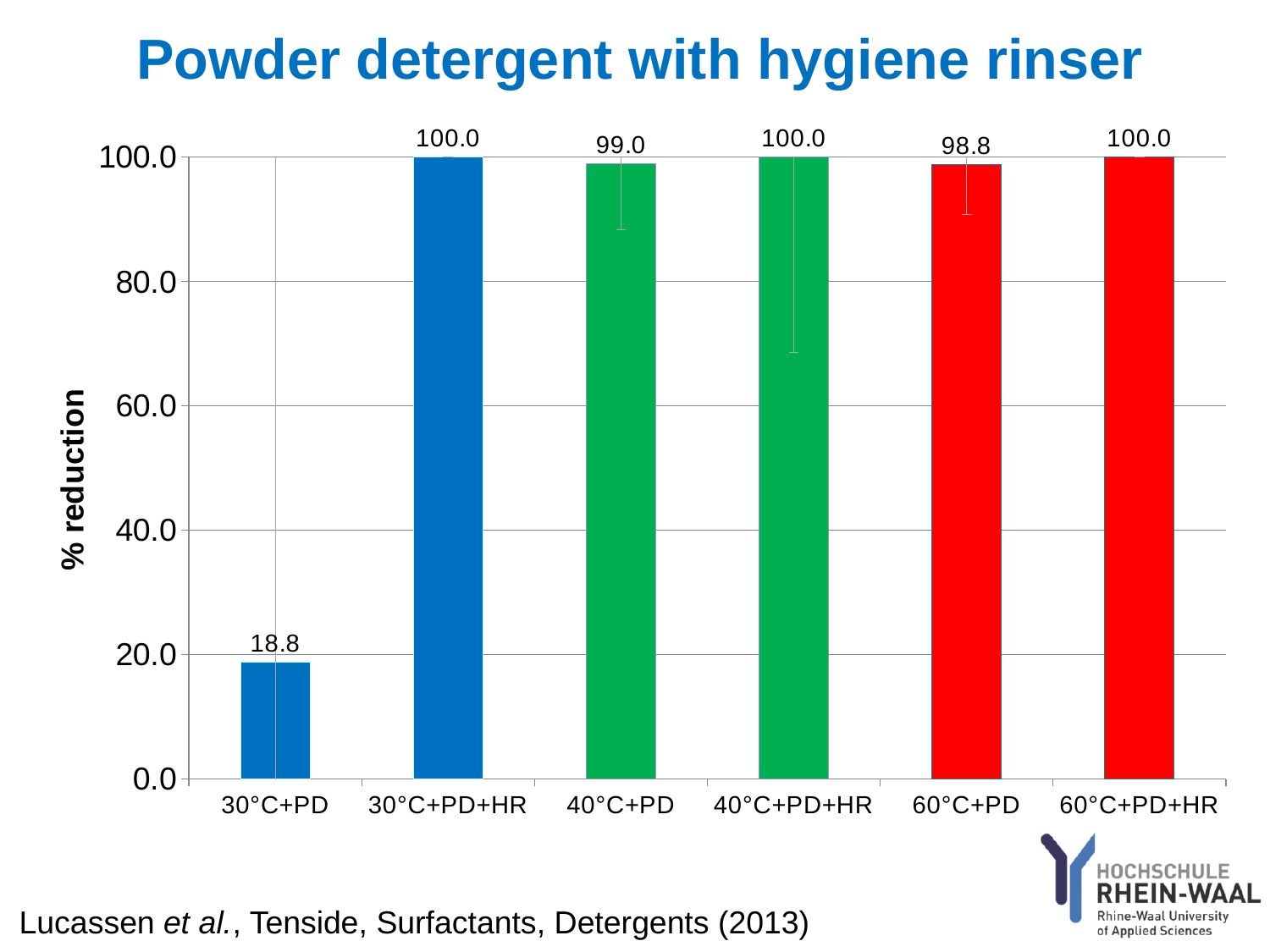
Is the value for 30°C+PD greater or less than 20.0? less Which has a larger % reduction, 30°C+PD or 40°C+PD? 40°C+PD What is the % reduction for 30°C+PD+HR? 100.0 What is the difference in % reduction between 30°C+PD+HR and 30°C+PD? 81.2 What is the % reduction for 40°C+PD? 99.0 What is the % reduction for 30°C+PD? 18.8 How many categories are shown on the x axis? 6 What is the % reduction for 60°C+PD? 98.8 Which category has the lowest % reduction? 30°C+PD What is the difference in % reduction between 40°C+PD and 60°C+PD? 0.2 What kind of chart is shown on the slide? bar chart What is the label of the y axis? % reduction